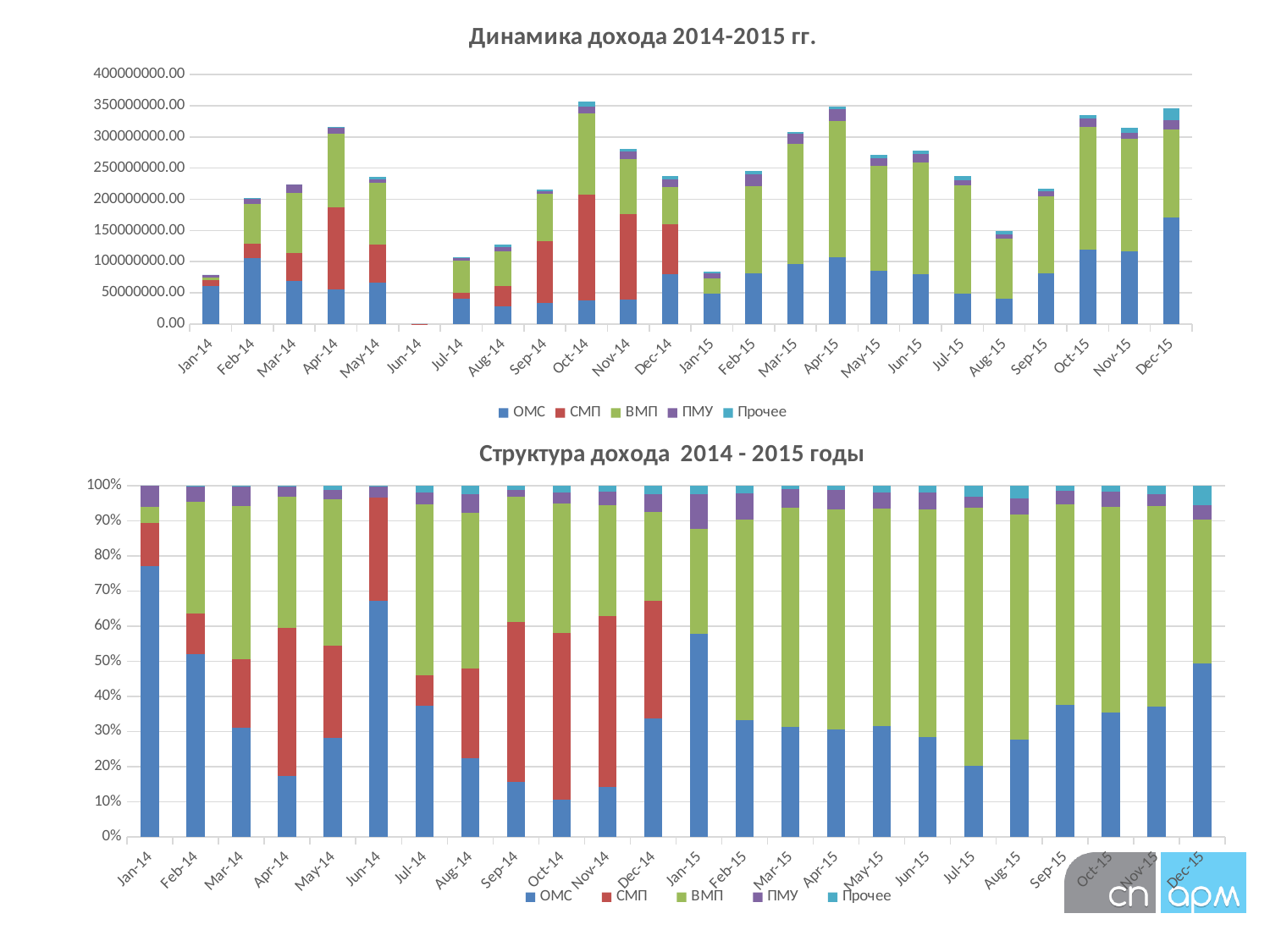
In the top chart "Динамика дохода 2014-2015 гг.", is the total for Apr-14 greater or less than 300000000.00? greater What kind of chart is the top chart titled "Динамика дохода 2014-2015 гг."? Stacked bar chart In the bottom chart "Структура дохода 2014 - 2015 годы", is the ОМС share for Jul-15 greater or less than 30%? less In the top chart "Динамика дохода 2014-2015 гг.", do the total bars rise or fall from Jan-14 to Apr-14? rise In the top chart "Динамика дохода 2014-2015 гг.", is the total for Jan-14 greater or less than 100000000.00? less In the bottom chart "Структура дохода 2014 - 2015 годы", which is larger: the ОМС share in Jan-14 or in Feb-14? Jan-14 How many months (categories) are shown on the x axis of the bottom chart "Структура дохода 2014 - 2015 годы"? 24 In the top chart "Динамика дохода 2014-2015 гг.", which month has the lowest total bar? Jun-14 In the bottom chart "Структура дохода 2014 - 2015 годы", which month has the highest share of ОМС? Jan-14 How many series does the legend of the top chart "Динамика дохода 2014-2015 гг." list? 5 What are the legend entries of the bottom chart "Структура дохода 2014 - 2015 годы"? ОМС, СМП, ВМП, ПМУ, Прочее